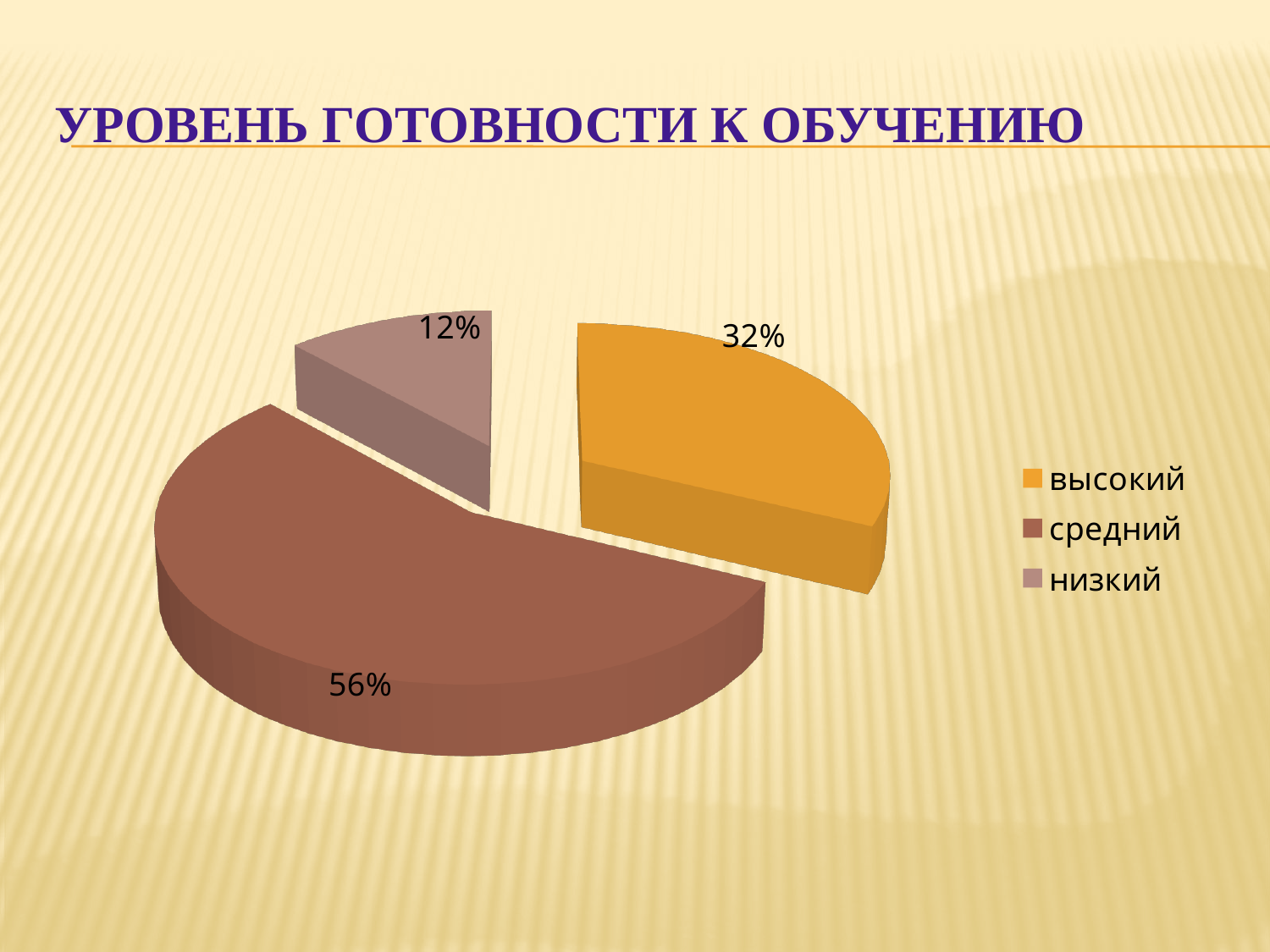
What is the difference in percentage points between the "высокий" and "низкий" slices? 20 Which category has the largest slice of the pie? средний What share of the pie does the "средний" slice represent? 56% What kind of chart is shown on the slide? pie chart Which colour represents the "высокий" category in the legend? orange What share of the pie does the "низкий" slice represent? 12% What is the difference in percentage points between the "средний" and "высокий" slices? 24 What is the title of the slide? УРОВЕНЬ ГОТОВНОСТИ К ОБУЧЕНИЮ Which category has the smallest slice of the pie? низкий Which slice is larger, "высокий" or "низкий"? высокий How many slices does the pie chart have? 3 What share of the pie does the "высокий" slice represent? 32%